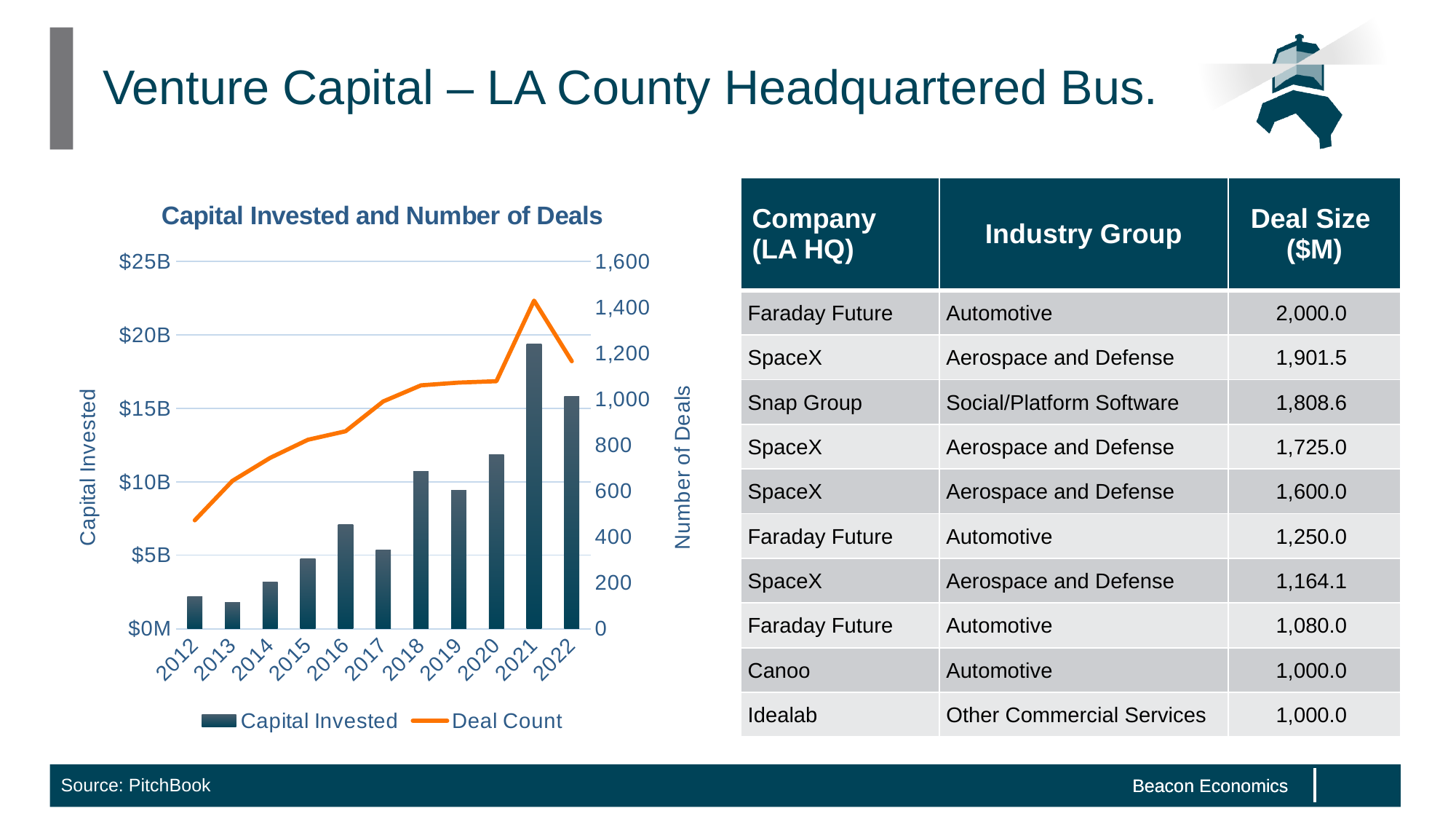
What is the title of the chart on the slide? Capital Invested and Number of Deals What kind of chart is shown on the slide? A combination bar and line chart Is the Deal Count value for 2021 greater or less than 1,200? greater Is the Capital Invested value for 2017 greater or less than $10B? less Does the Deal Count line generally rise or fall from 2012 to 2021? rise Is the Deal Count value for 2012 greater or less than 600? less Which year has the larger Capital Invested value, 2021 or 2022? 2021 Which year has the highest Capital Invested bar? 2021 How many series does the chart legend list? 2 How many years are shown on the x axis of the chart? 11 What is the label of the right-hand vertical axis of the chart? Number of Deals